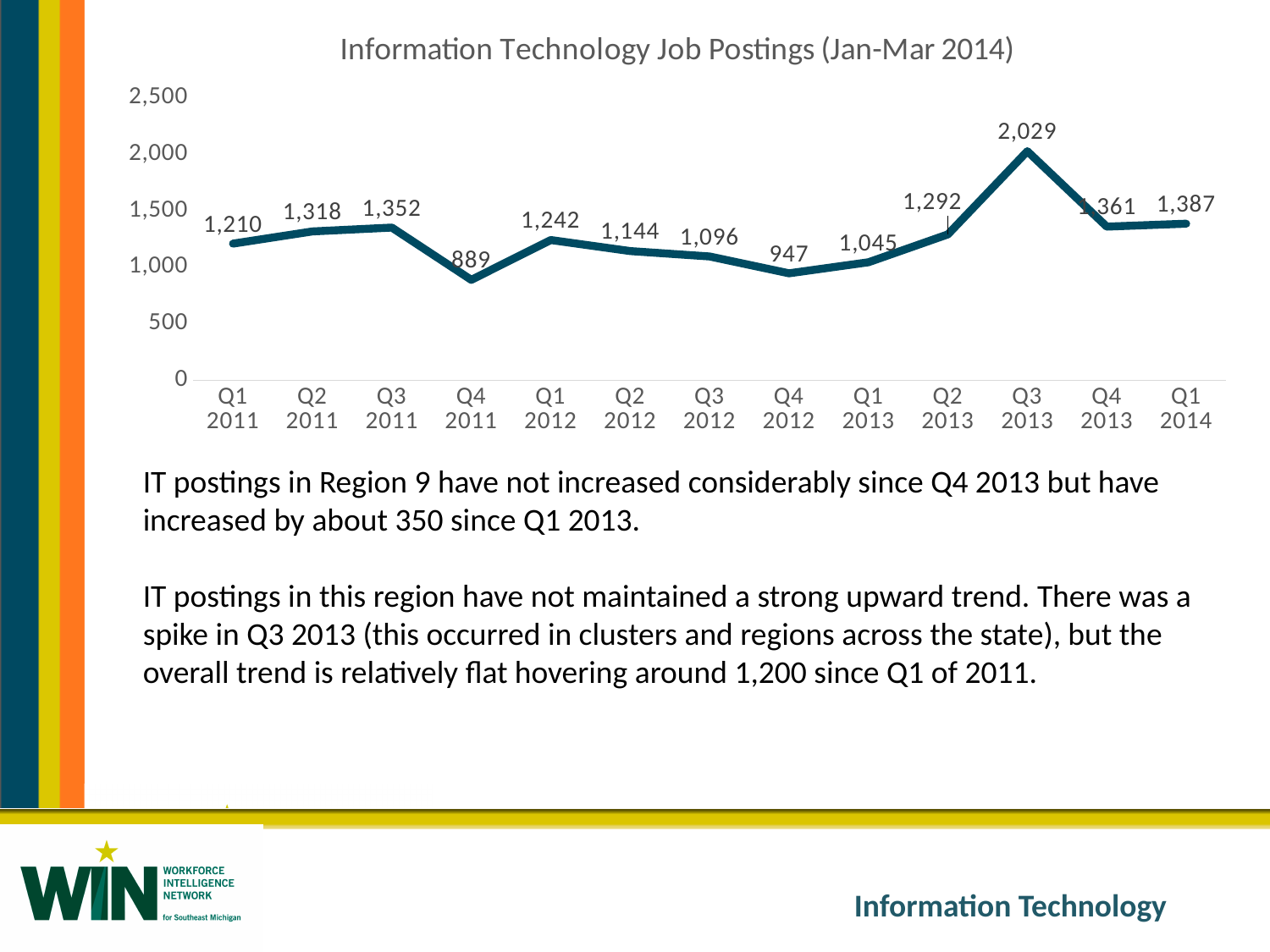
Which is larger, the value for Q2 2011 or the value for Q2 2012? Q2 2011 Which quarter has the highest number of IT job postings? Q3 2013 What is the difference between the values for Q3 2013 and Q1 2013? 984 Which quarter has the lowest number of IT job postings? Q4 2011 What is the title of the chart? Information Technology Job Postings (Jan-Mar 2014) What is the value for Q4 2012? 947 What kind of chart is shown on the slide? line chart How many quarters are plotted on the x axis? 13 Do the values rise or fall from Q3 2013 to Q4 2013? fall What is the value for Q1 2014? 1,387 What is the value for Q3 2013? 2,029 What is the value for Q1 2011? 1,210